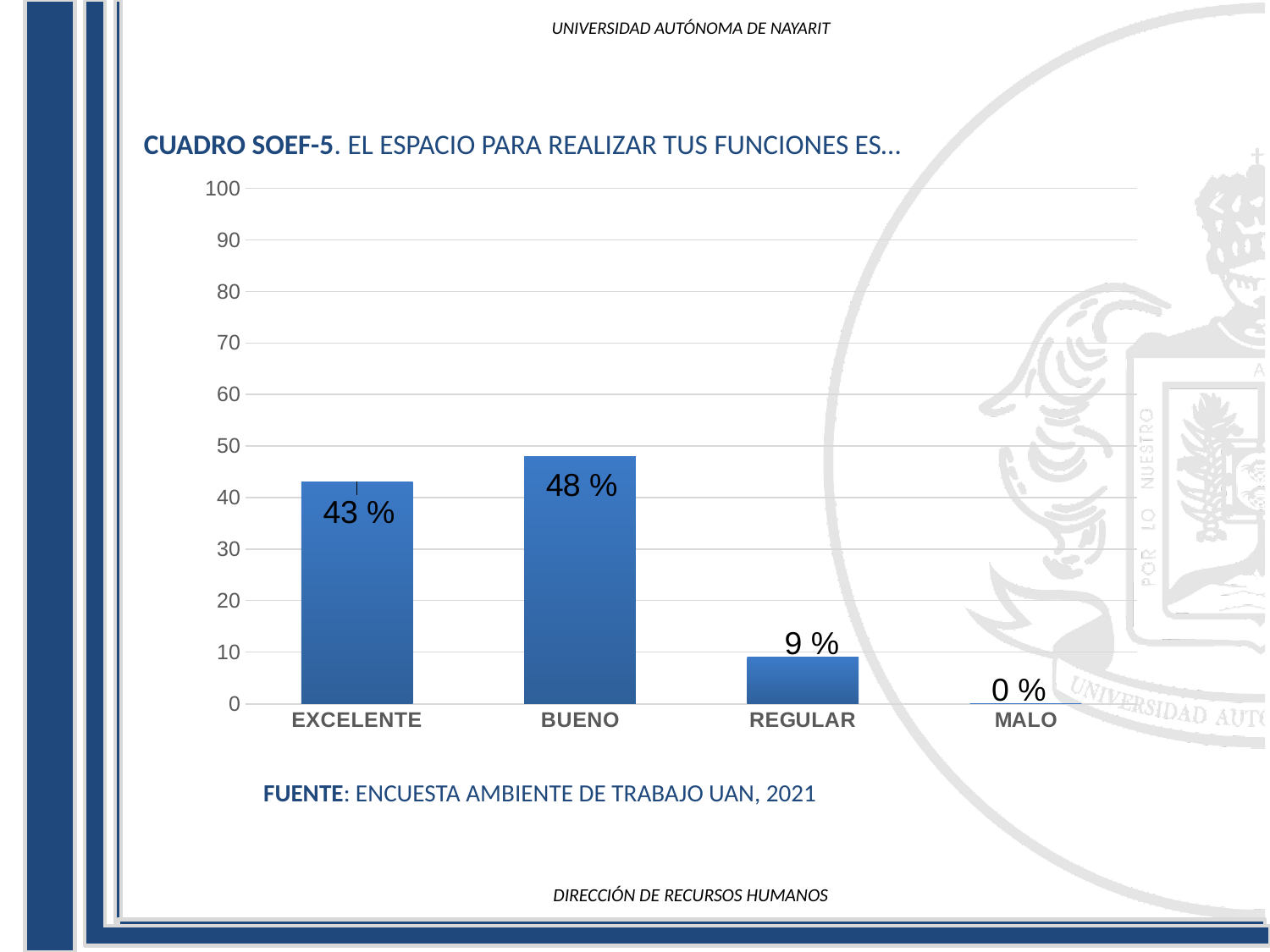
Which is larger, the value for EXCELENTE or the value for REGULAR? EXCELENTE What is the source cited below the chart? ENCUESTA AMBIENTE DE TRABAJO UAN, 2021 Which category has the highest value? BUENO What is the difference between the values for BUENO and EXCELENTE? 5 % What is the value for MALO? 0 % What is the value for BUENO? 48 % What is the value for EXCELENTE? 43 % What is the value for REGULAR? 9 % How many categories are shown on the x axis? 4 What kind of chart is shown on the slide? bar chart Is the value for REGULAR greater or less than 10? less Which category has the lowest value? MALO